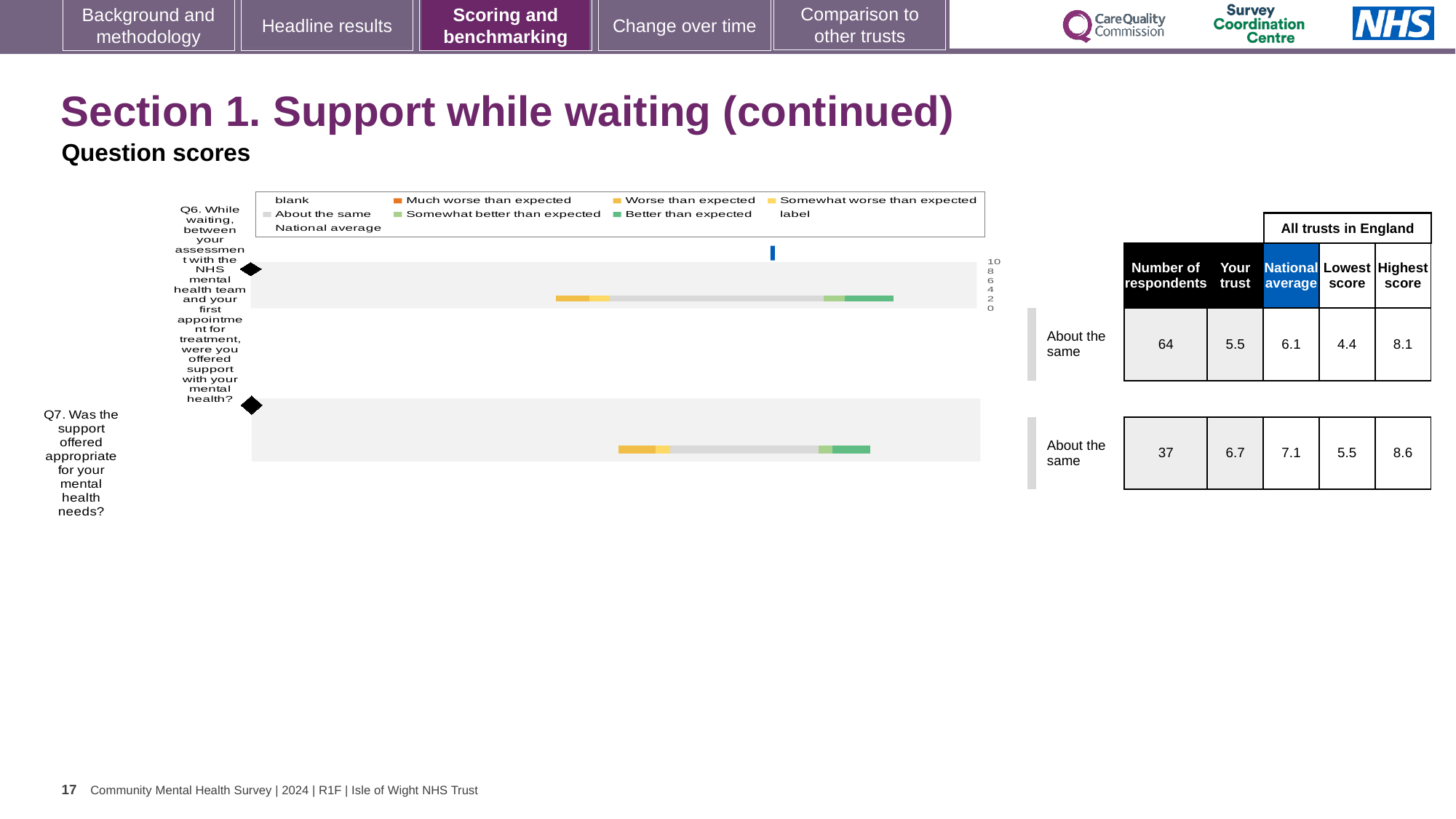
How many respondents answered Q6? 64 What is the national average score for Q7? 7.1 What is the 'Your trust' score for Q7 (was the support offered appropriate for your mental health needs)? 6.7 What is the national average score for Q6? 6.1 What is the difference between the national average and the 'Your trust' score for Q6? 0.6 Is the 'Your trust' score for Q7 greater or less than 6? greater Which question has the higher 'Your trust' score, Q6 or Q7? Q7 What is the difference between the highest score and the lowest score for Q7 across all trusts in England? 3.1 How many questions (bars) are plotted in the chart? 2 What benchmark category is shown for Q6 next to the chart? About the same What kind of chart is used to show the question scores on this slide? bar chart What is the 'Your trust' score for Q6 (support while waiting between assessment and first appointment)? 5.5